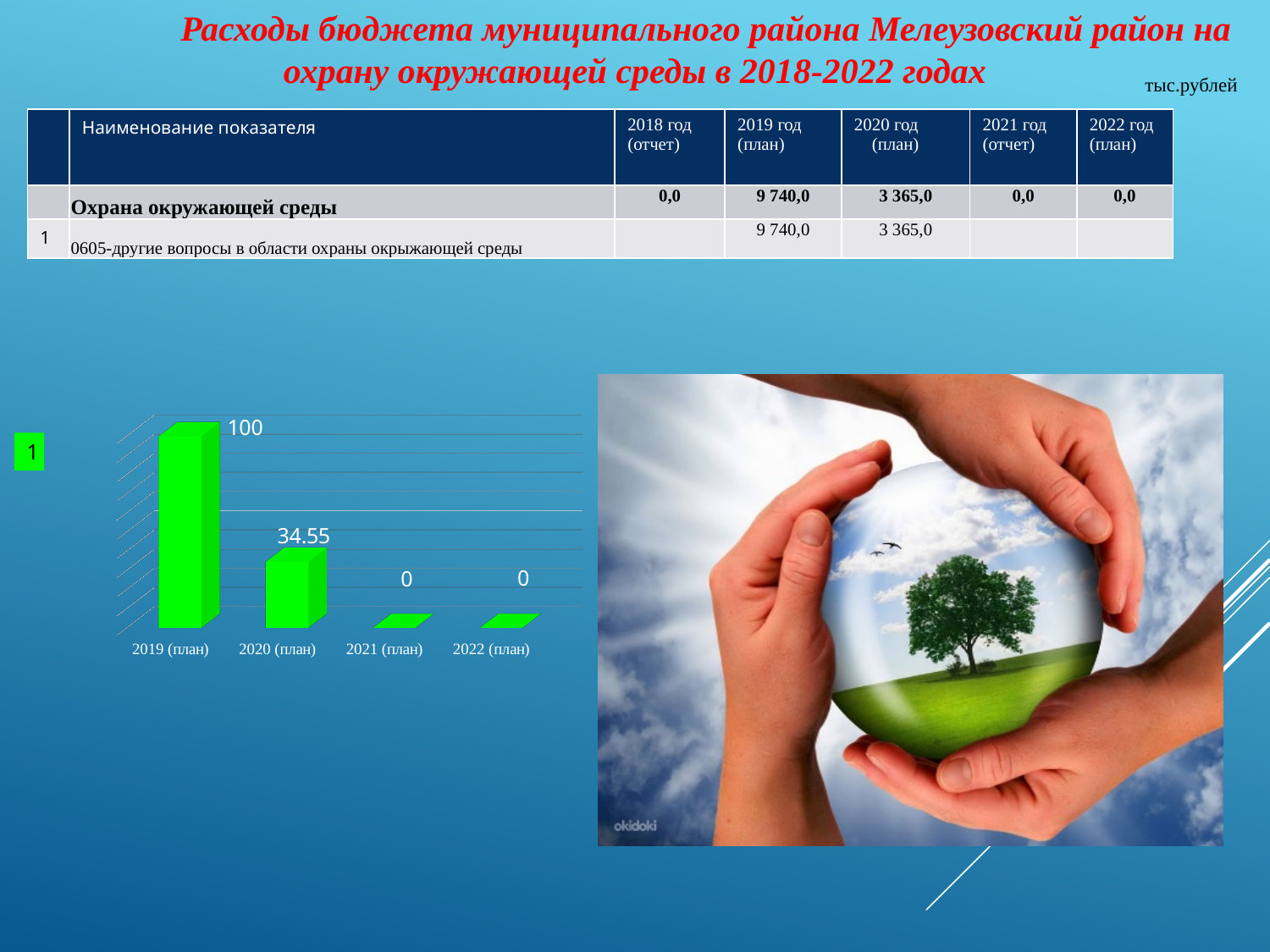
What is the value for 2022 (план) in the bar chart? 0 What is the difference between the values for 2019 (план) and 2020 (план)? 65.45 What is the difference between the values for 2020 (план) and 2021 (план)? 34.55 How many categories are plotted in the bar chart? 4 What type of chart is shown on the slide? bar chart What colour are the bars in the bar chart? green What is the value for 2020 (план) in the bar chart? 34.55 Which category has the highest value in the bar chart? 2019 (план) Which is larger in the bar chart, the value for 2019 (план) or 2020 (план)? 2019 (план) Do the values in the bar chart rise or fall from 2019 (план) to 2022 (план)? fall What is the value for 2021 (план) in the bar chart? 0 What is the value for 2019 (план) in the bar chart? 100